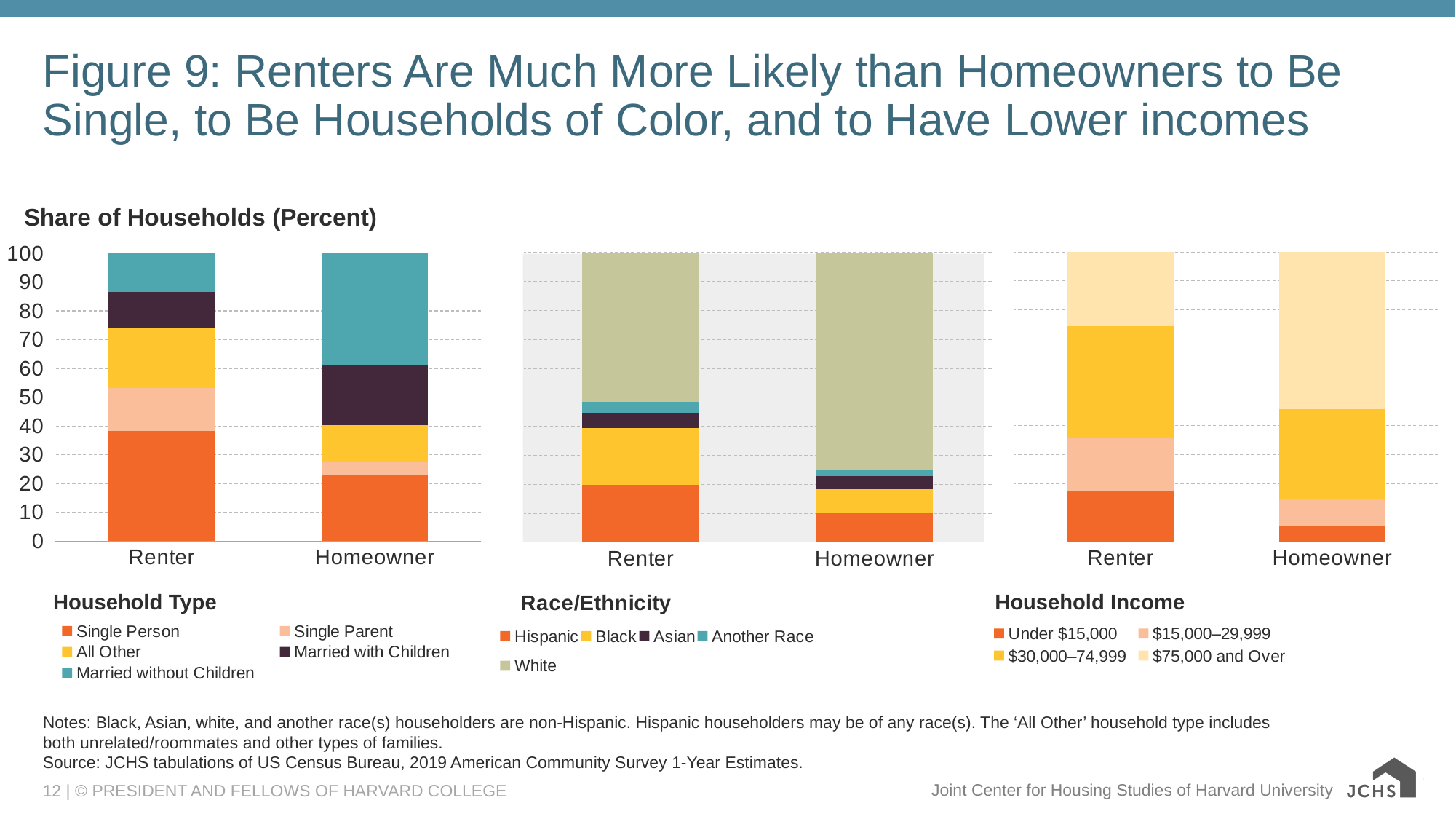
What kind of chart is the Household Type chart? stacked bar chart In the Household Income chart, which has the larger Under $15,000 share, Renter or Homeowner? Renter How many series does the legend of the Household Type chart list? 5 In the Household Income chart, is the $75,000 and Over share for Renter greater or less than 30? less In the Household Type chart, is the Single Person share for Renter greater or less than 30? greater In the Race/Ethnicity chart, which has the larger White share, Renter or Homeowner? Homeowner In the Household Type chart, is the Single Person share for Homeowner greater or less than 30? less In the Household Type chart, which has the larger Single Person share, Renter or Homeowner? Renter How many series does the legend of the Household Income chart list? 4 How many categories are shown on the x axis of the Race/Ethnicity chart? 2